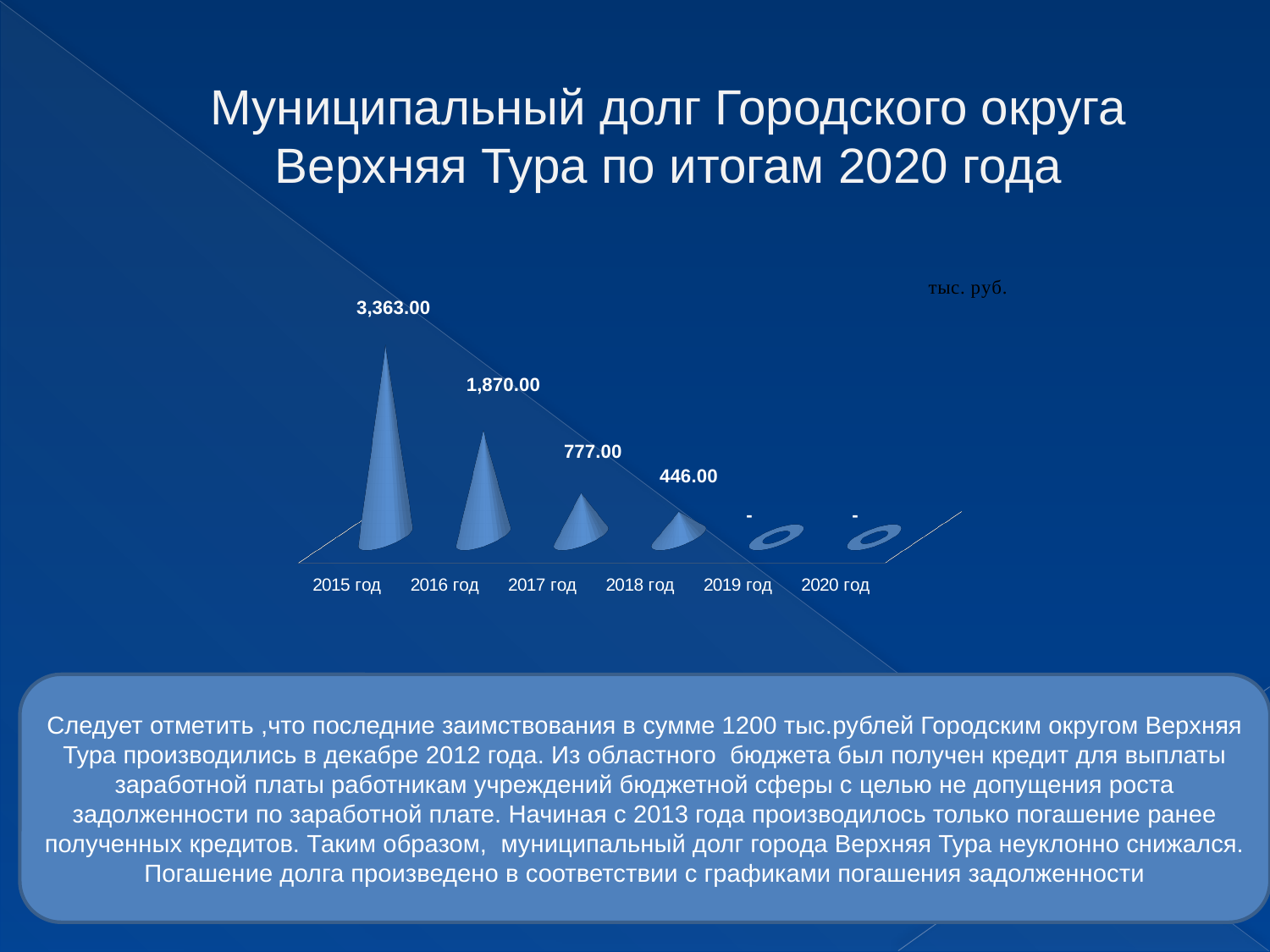
What is the municipal debt value shown for 2015 год? 3,363.00 What is the difference between the values for 2017 год and 2018 год? 331.00 Which is larger, the value for 2016 год or the value for 2017 год? 2016 год What is the municipal debt value shown for 2018 год? 446.00 What unit is indicated for the values on the chart? тыс. руб. Which year has the highest municipal debt value on the chart? 2015 год What is the municipal debt value shown for 2017 год? 777.00 What is the municipal debt value shown for 2016 год? 1,870.00 What is the difference between the values for 2015 год and 2016 год? 1,493.00 Do the values rise or fall from 2015 год to 2018 год? fall How many years (categories) are shown on the x axis of the chart? 6 What kind of chart is shown on the slide? bar chart